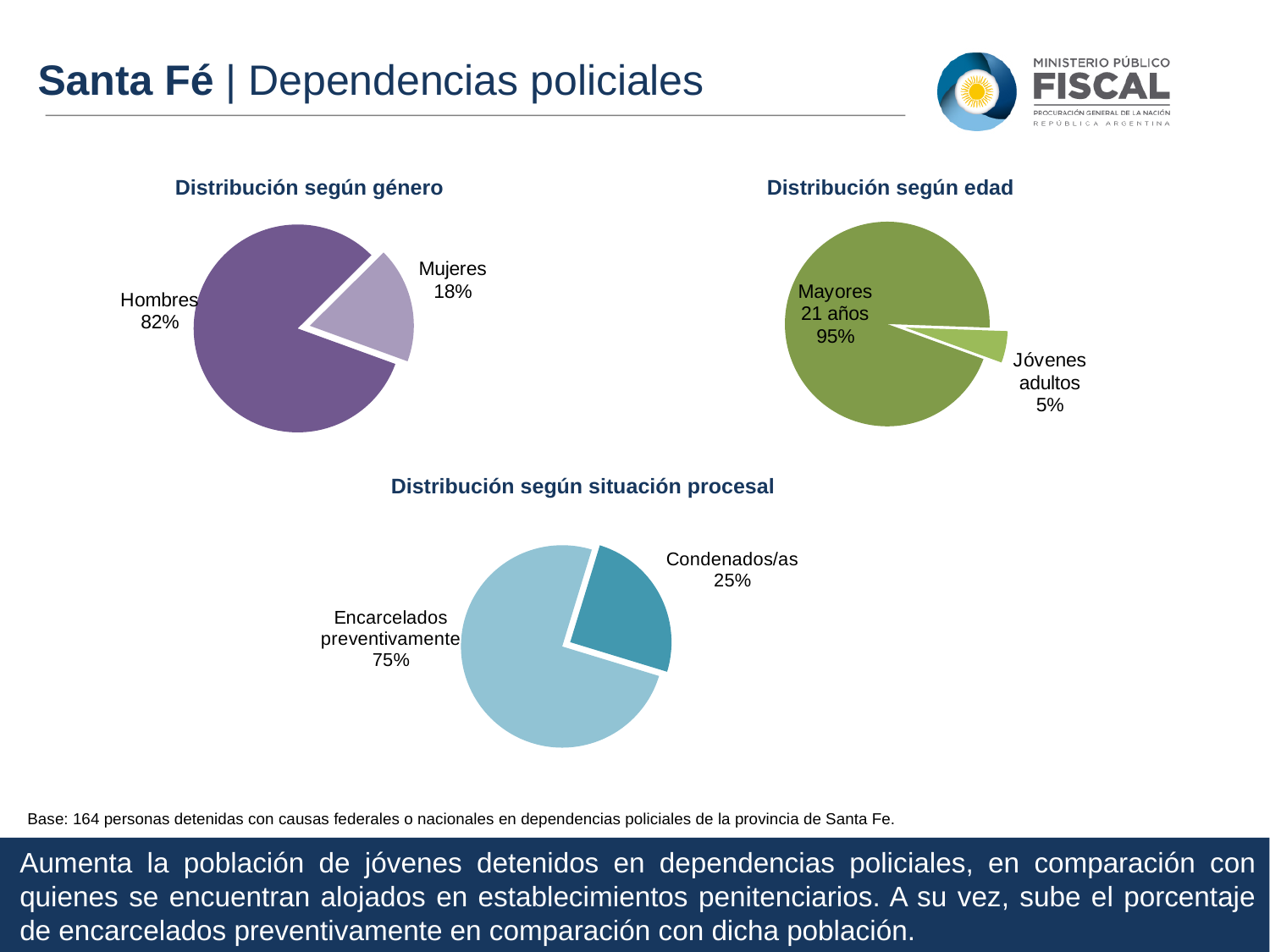
In the 'Distribución según edad' chart, what percentage is shown for Mayores 21 años? 95% How many categories does the 'Distribución según edad' chart show? 2 How many pie charts are on the slide? 3 In the 'Distribución según género' chart, what percentage is shown for Mujeres? 18% In the 'Distribución según situación procesal' chart, what percentage is shown for Condenados/as? 25% In the 'Distribución según género' chart, what is the difference in percentage points between Hombres and Mujeres? 64 In the 'Distribución según situación procesal' chart, which is larger: Encarcelados preventivamente or Condenados/as? Encarcelados preventivamente In the 'Distribución según edad' chart, which category has the smallest share? Jóvenes adultos In the 'Distribución según género' chart, what percentage is shown for Hombres? 82% In the 'Distribución según situación procesal' chart, which category has the largest share? Encarcelados preventivamente What type of chart is 'Distribución según situación procesal'? Pie chart In the 'Distribución según edad' chart, what percentage is shown for Jóvenes adultos? 5%